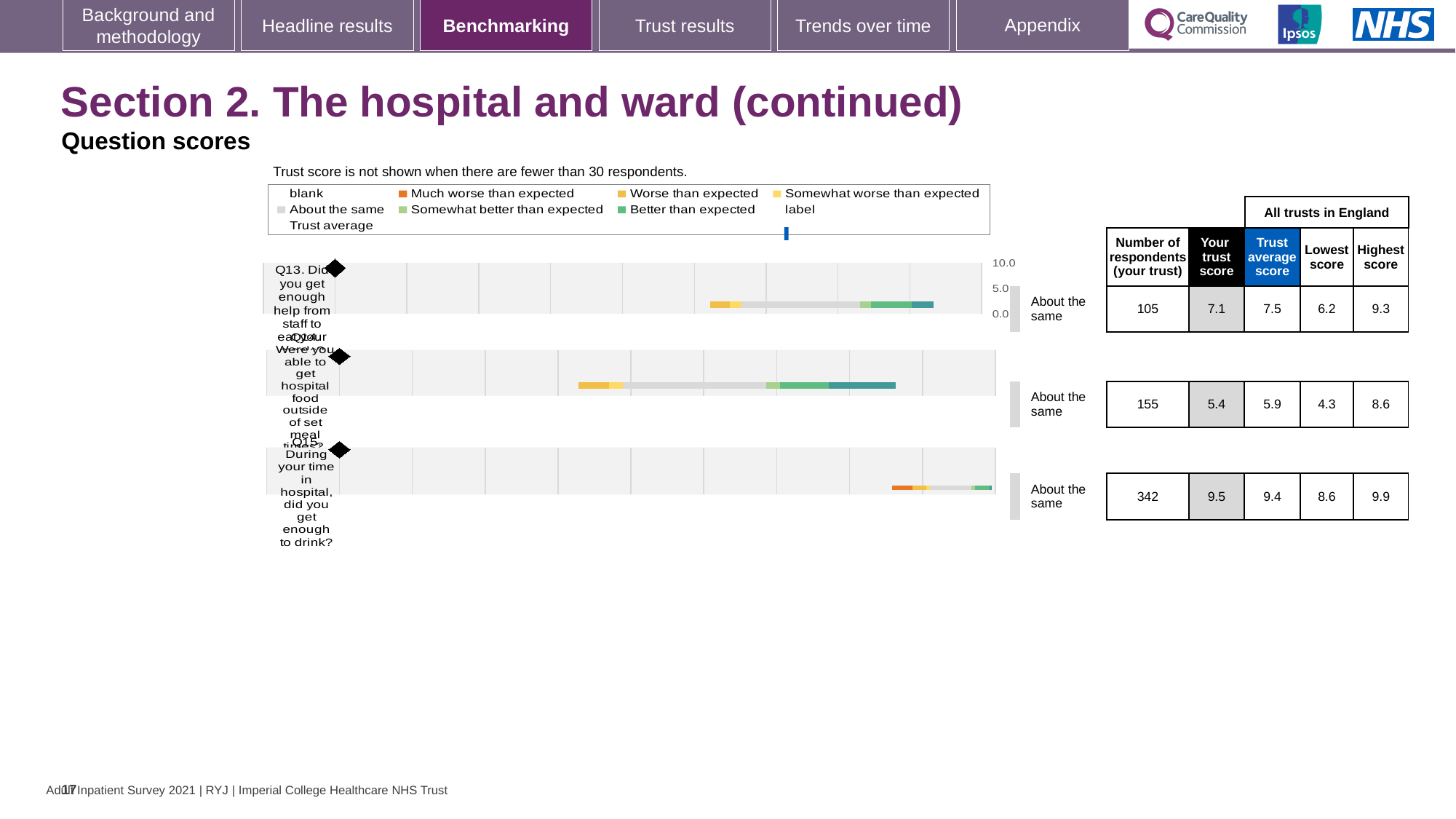
What benchmark category is shown next to the Q14 bar? About the same How many respondents answered Q15 (did you get enough to drink?) at this trust? 342 What is the lowest score across all trusts in England for Q14? 4.3 How many questions (Q13, Q14, Q15) are plotted on the chart? 3 For Q13, which is larger: the 'Your trust score' or the trust average score? Trust average score What kind of chart is used to show the question scores on this slide? bar chart What is the difference between the highest score and the lowest score for Q15? 1.3 Which question has the lowest 'Your trust score'? Q14 What is the 'Your trust score' for Q13 (Did you get enough help from staff to eat your meals?)? 7.1 What is the difference between the trust average score and the 'Your trust score' for Q13? 0.4 Which question has the highest 'Your trust score'? Q15 What is the trust average score for Q14 (Were you able to get hospital food outside of set meal times?)? 5.9